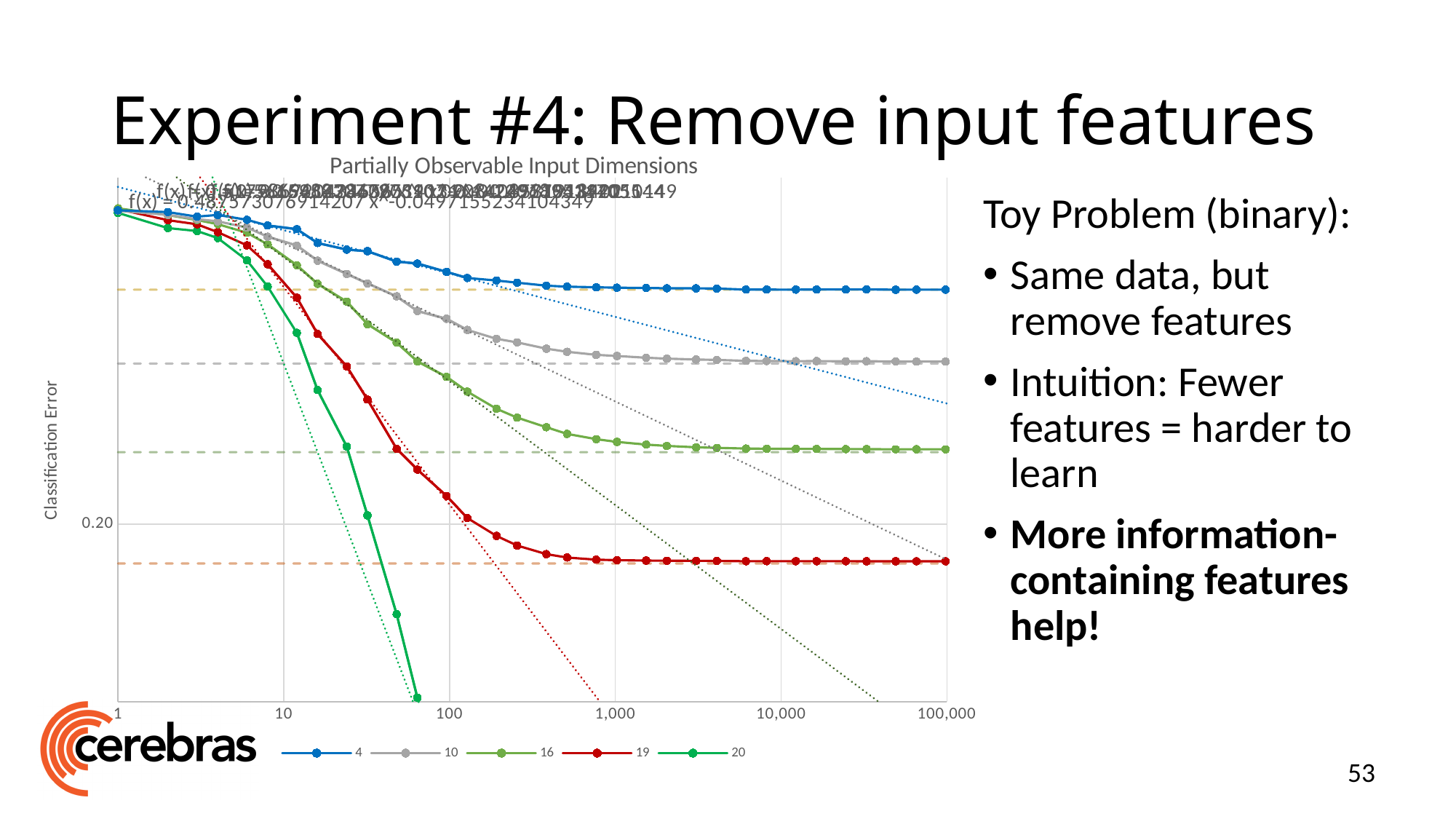
What is the title of the chart? Partially Observable Input Dimensions How many series does the chart legend list? 5 Which series has the highest classification error at x = 100,000? 4 At x = 100,000, is the classification error for series 4 greater or less than 0.20? greater At x = 100,000, is the classification error for series 19 greater or less than 0.20? less At x = 100,000, which series has the larger classification error, 10 or 16? 10 At x = 1,000, which series has the larger classification error, 16 or 19? 16 What is the largest value labelled on the x axis of the chart? 100,000 What is the label on the vertical axis of the chart? Classification Error Do the classification error values rise or fall as the x axis increases? Fall Among the series that reach x = 100,000, which has the lowest classification error there? 19 What kind of chart is shown on the slide? Line chart